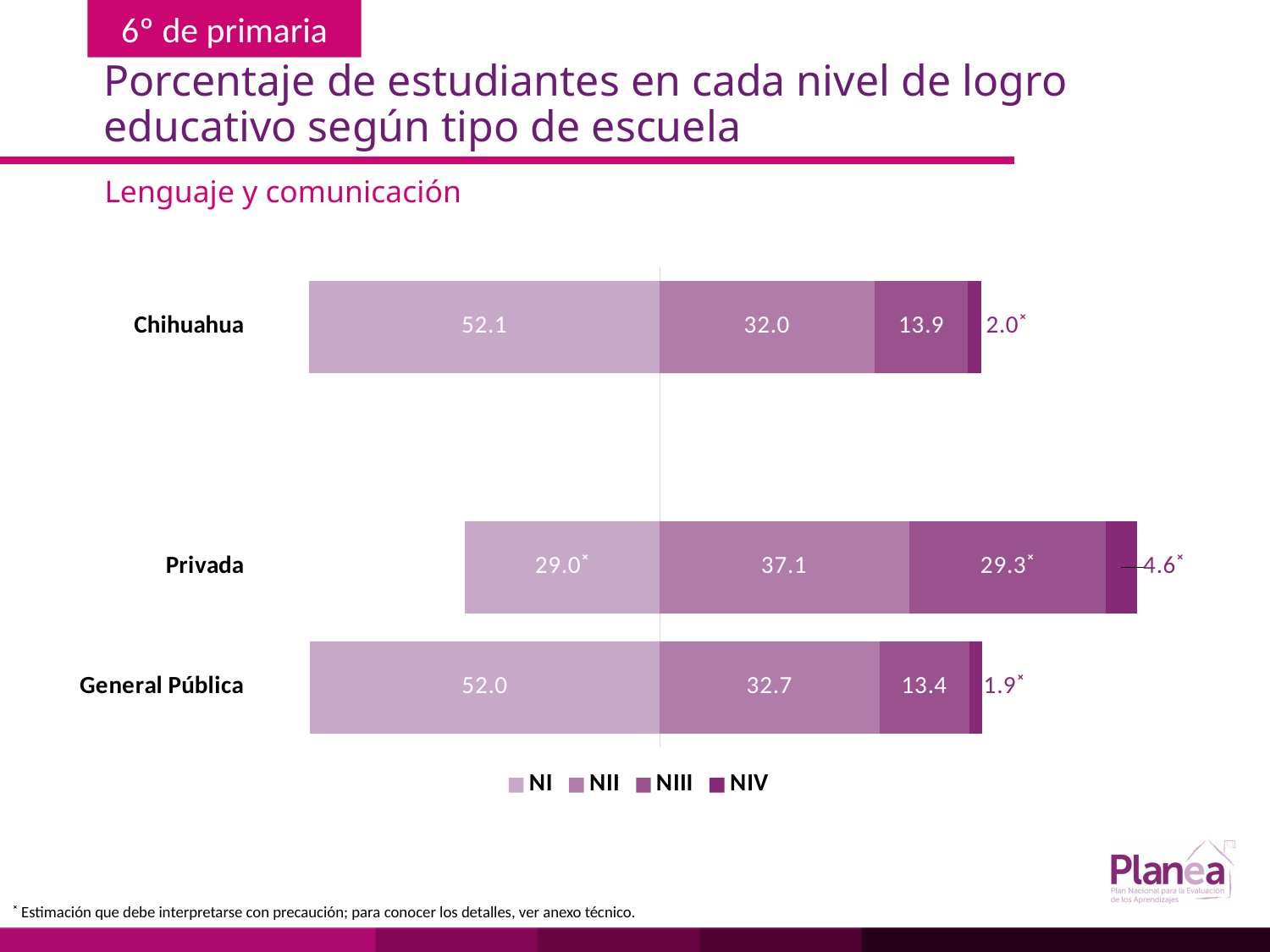
Which is larger, the NIII value for Privada or for General Pública? Privada What percentage of Chihuahua students are at level NI? 52.1 What is the total of the stacked bar for General Pública? 100.0 Which school type has the highest NIII value? Privada What is the NII value for Privada schools? 37.1 What kind of chart is shown on the slide? Stacked bar chart What is the difference between the NII values for Privada and Chihuahua? 5.1 How many series does the legend list? 4 What is the NIV value for Privada schools? 4.6 Which school type has the lowest NI value? Privada How many school types (categories) are shown in the chart? 3 What is the NIII value for General Pública schools? 13.4